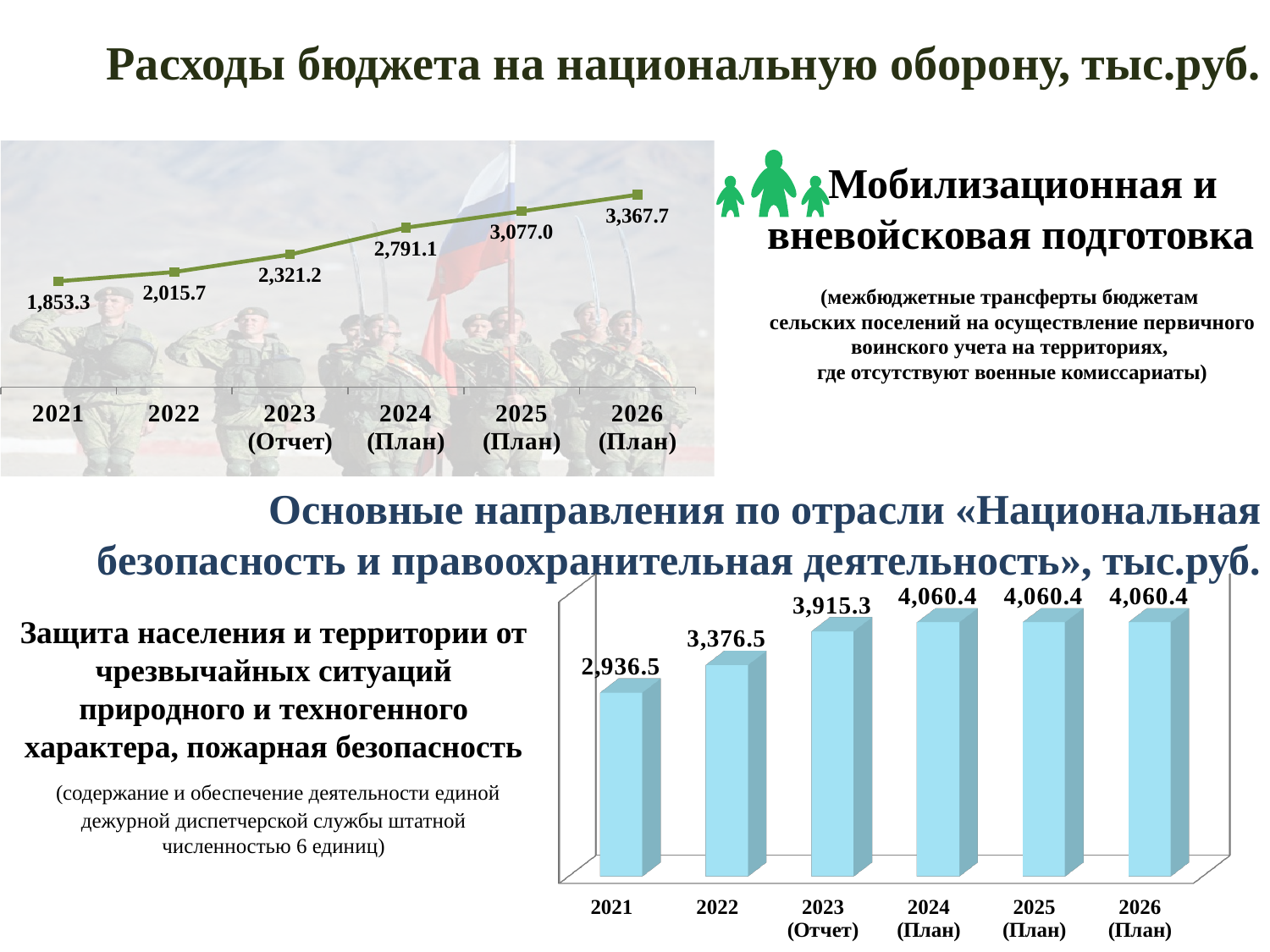
In the bottom bar chart on national security and law enforcement, what is the value for 2022? 3,376.5 What kind of chart is the top chart on national defence expenditure? line chart How many years are plotted in the bottom bar chart on national security and law enforcement? 6 In the top line chart on national defence expenditure, do the values rise or fall from 2021 to 2026? rise In the top line chart on national defence expenditure, what is the value for 2024 (План)? 2,791.1 In the bottom bar chart on national security and law enforcement, what is the difference between the 2023 (Отчет) and 2021 values? 978.8 In the top line chart on national defence expenditure, which year has the highest value? 2026 (План) In the top line chart on national defence expenditure, what is the difference between the 2026 (План) and 2025 (План) values? 290.7 In the bottom bar chart on national security and law enforcement, which year has the lowest value? 2021 What kind of chart is the bottom chart on national security and law enforcement? bar chart In the bottom bar chart on national security and law enforcement, which is larger: the value for 2022 or the value for 2023 (Отчет)? 2023 (Отчет) In the top line chart on national defence expenditure, what is the value for 2021? 1,853.3